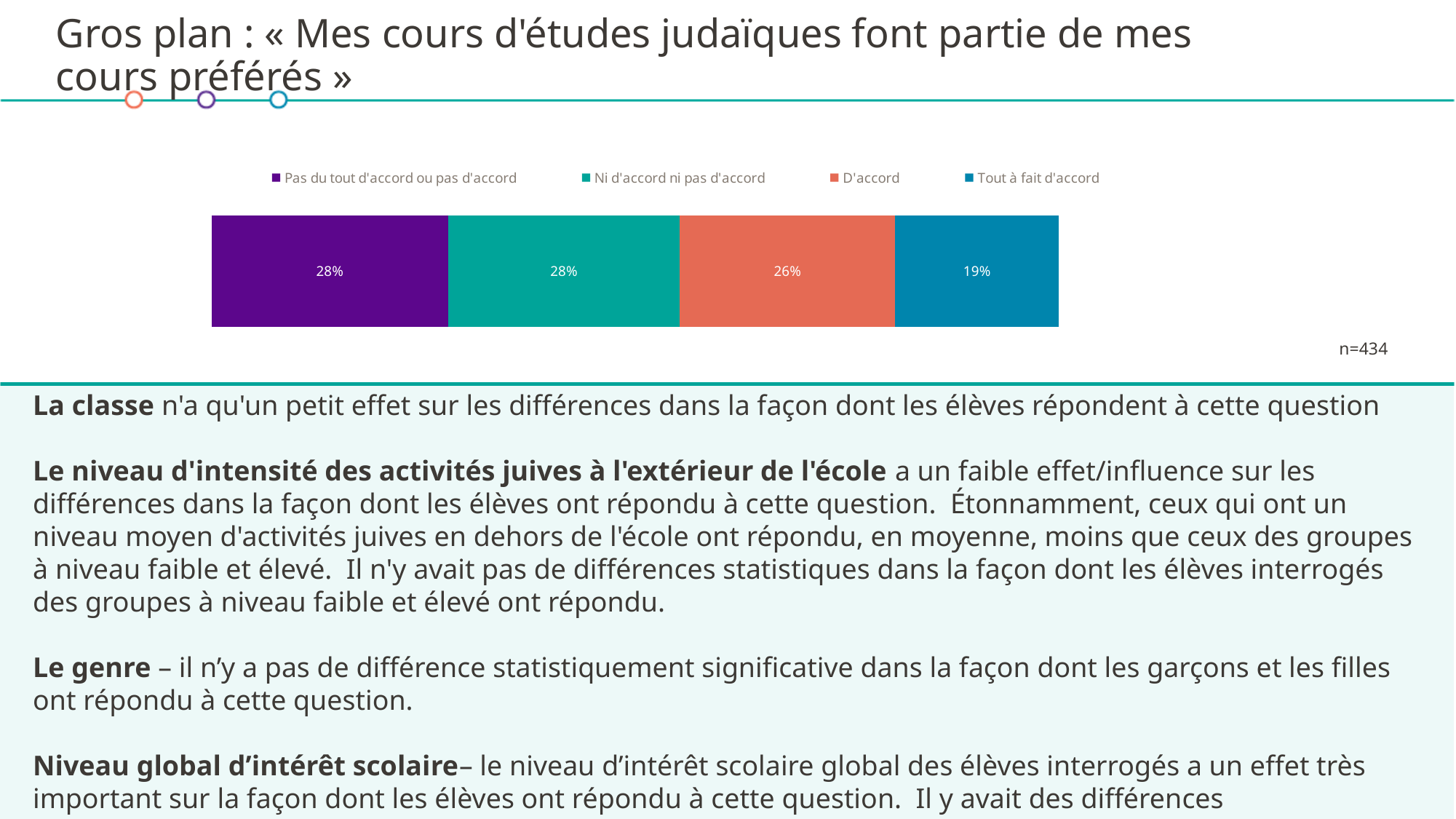
What percentage of respondents answered "Tout à fait d'accord"? 19% Which response category has the smallest share? Tout à fait d'accord What colour is the "D'accord" segment of the bar? Orange What percentage of respondents answered "Pas du tout d'accord ou pas d'accord"? 28% What is the difference in percentage points between "D'accord" and "Tout à fait d'accord"? 7 percentage points What kind of chart is shown on the slide? Stacked bar chart How many response categories does the legend list? 4 What is the sample size (n) shown next to the chart? n=434 What percentage of respondents answered "D'accord"? 26% What percentage of respondents answered "Ni d'accord ni pas d'accord"? 28% What is the difference in percentage points between "Ni d'accord ni pas d'accord" and "Tout à fait d'accord"? 9 percentage points Which is larger, the share for "D'accord" or the share for "Tout à fait d'accord"? D'accord